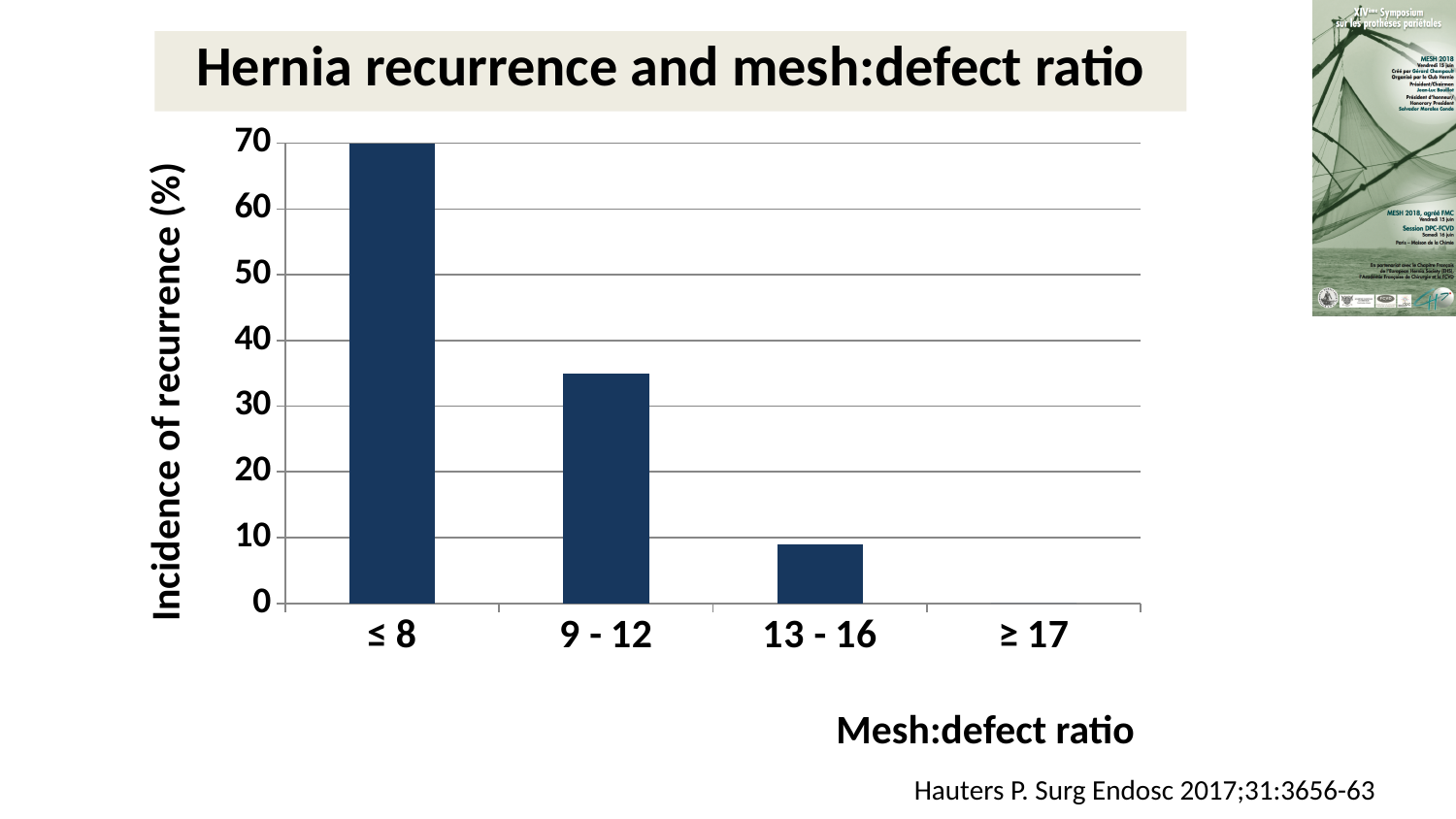
Which mesh:defect ratio category has the highest incidence of recurrence? ≤ 8 What is the title of the chart? Hernia recurrence and mesh:defect ratio Which has a higher incidence of recurrence, the 9 - 12 category or the 13 - 16 category? 9 - 12 What kind of chart is shown on the slide? bar chart What is the incidence of recurrence (%) for the ≥ 17 mesh:defect ratio category? 0 Is the incidence of recurrence for the 9 - 12 category greater or less than 40? less Is the incidence of recurrence for the 9 - 12 category greater or less than 30? greater Does the incidence of recurrence rise or fall as the mesh:defect ratio increases along the x axis? fall How many mesh:defect ratio categories are shown on the x axis? 4 Which mesh:defect ratio category has the lowest incidence of recurrence? ≥ 17 What is the incidence of recurrence (%) for the ≤ 8 mesh:defect ratio category? 70